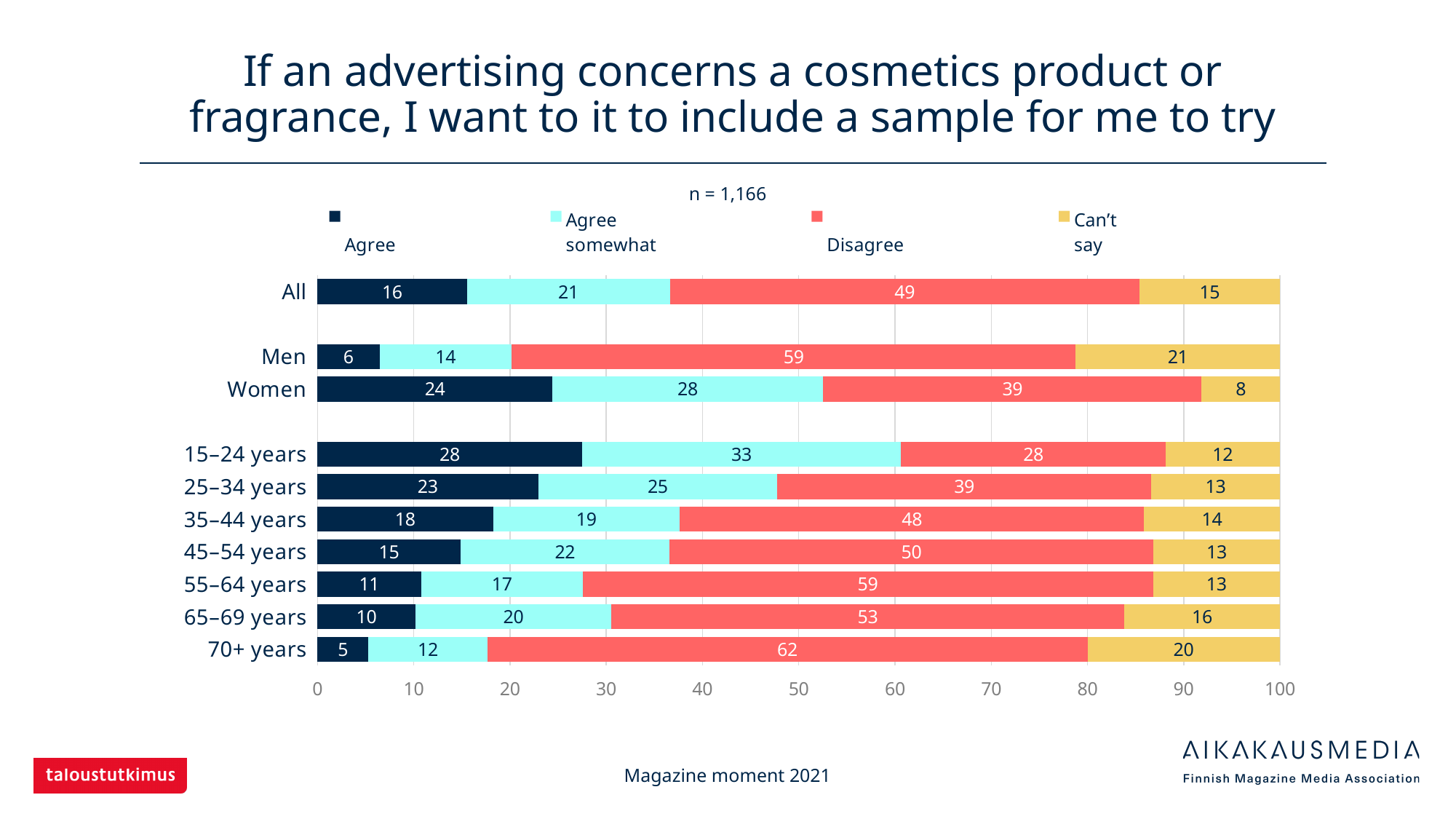
What is the total of the stacked bar for All? 101 What kind of chart is shown? Stacked bar chart What is the difference between the Disagree values for Men and Women? 20 Which category has the lowest Agree value? 70+ years How many series does the legend list? 4 What is the Disagree value for Men? 59 Which has a larger Agree somewhat value, 25–34 years or 35–44 years? 25–34 years Which category has the highest Agree value? 15–24 years What is the Agree value for Women? 24 How many categories are shown on the y axis? 10 What is the Can't say value for 70+ years? 20 What is the sample size shown above the chart? n = 1,166